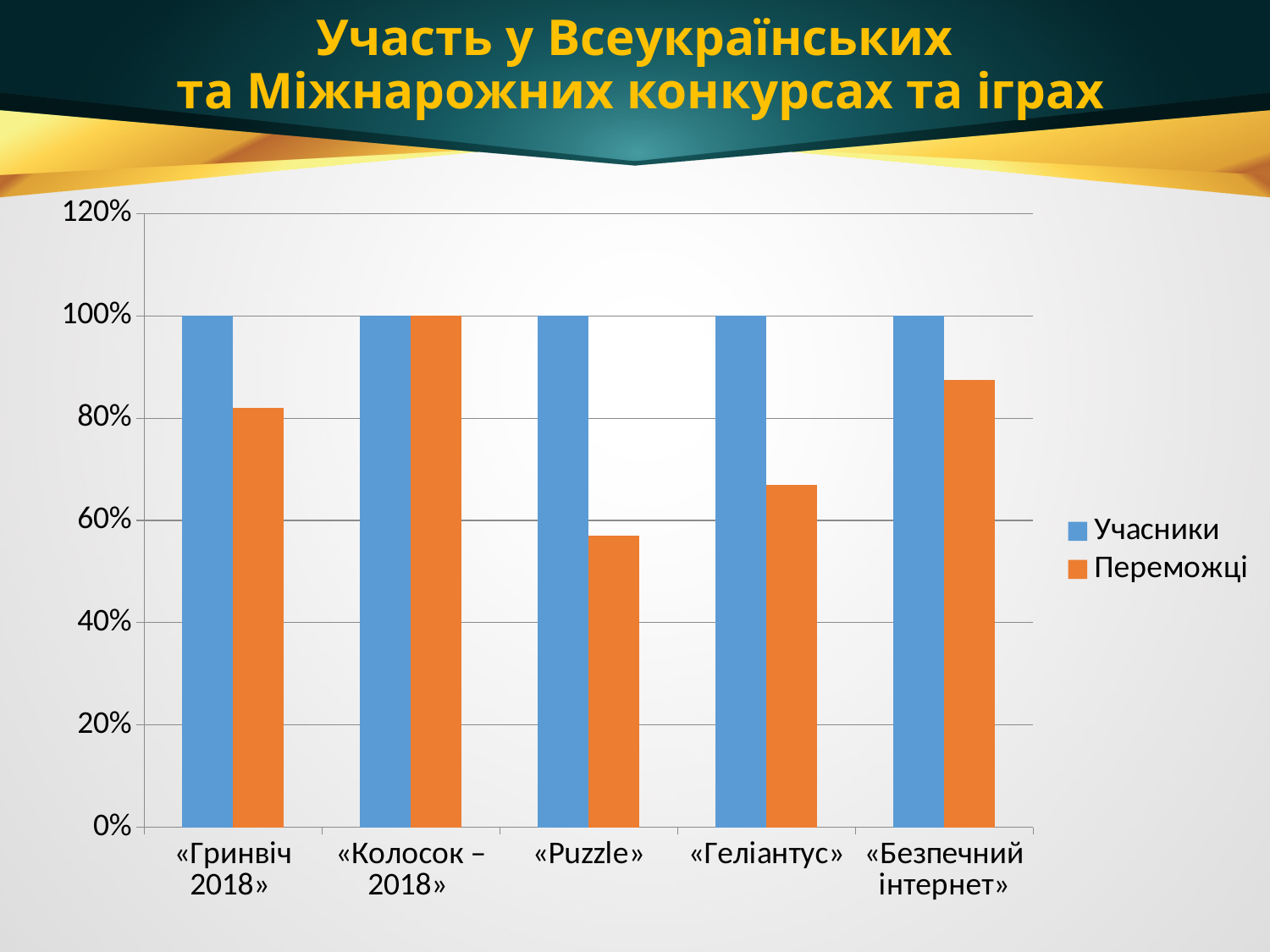
Is the value of Переможці for «Puzzle» greater or less than 60%? less Is the value of Переможці for «Безпечний інтернет» greater or less than 80%? greater How many categories (contests) are shown on the x axis? 5 Is the value of Переможці for «Гринвіч 2018» greater or less than 80%? greater How many series does the legend list? 2 What is the value of Переможці for «Колосок – 2018»? 100% Which contest has the lowest value for Переможці? «Puzzle» Which contest has the highest value for Переможці? «Колосок – 2018» Which is larger for «Геліантус»: Учасники or Переможці? Учасники What is the value of Учасники for «Puzzle»? 100% What kind of chart is shown on the slide? bar chart What are the two series named in the legend? Учасники, Переможці